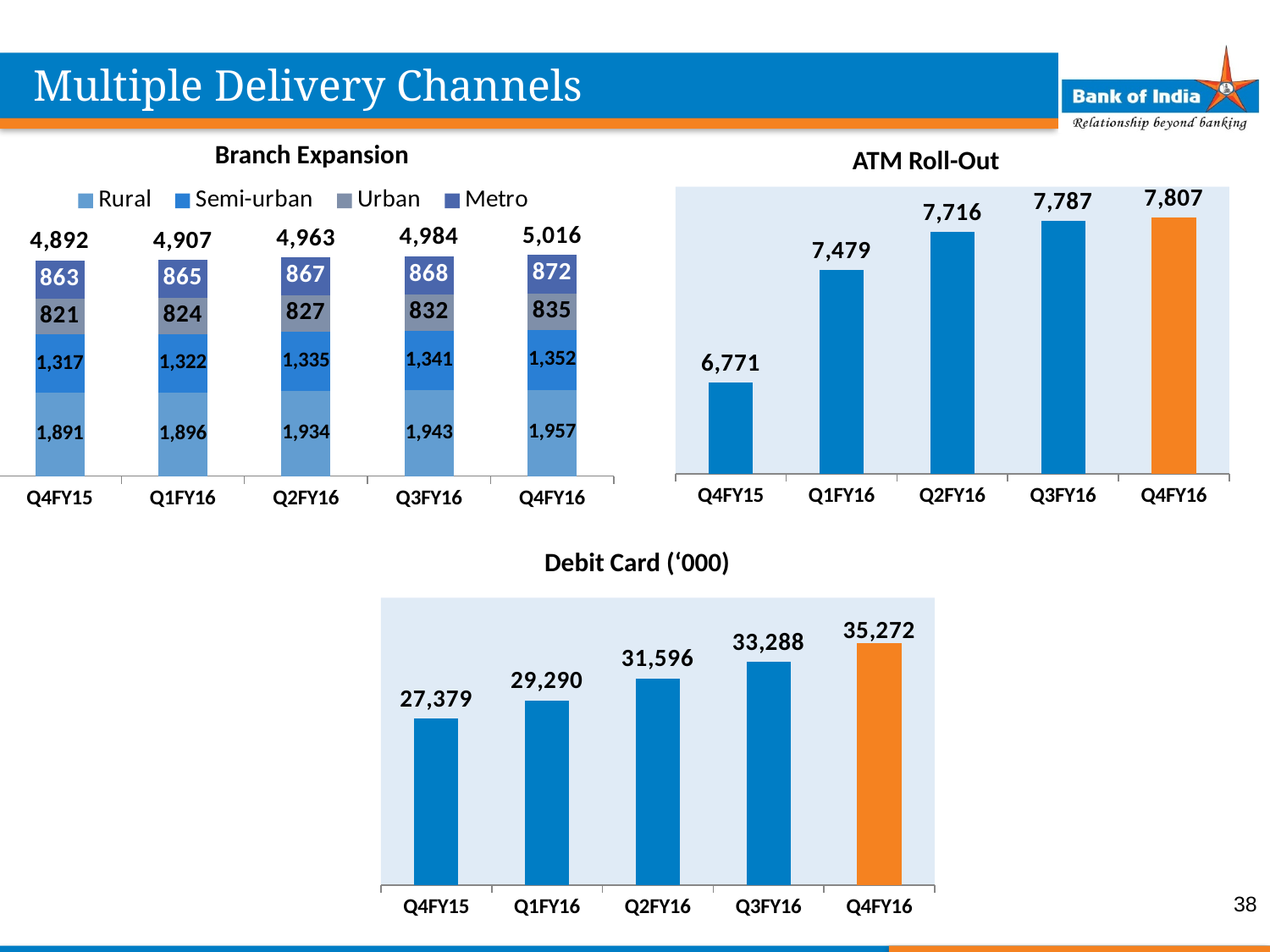
In the ATM Roll-Out chart, which quarter has the lowest value? Q4FY15 In the ATM Roll-Out chart, what is the value for Q1FY16? 7,479 In the ATM Roll-Out chart, what is the difference between Q4FY16 and Q4FY15? 1,036 In the Debit Card ('000) chart, what is the value for Q3FY16? 33,288 In the Debit Card ('000) chart, do the values rise or fall from Q4FY15 to Q4FY16? rise How many quarters are shown on the x axis of the Debit Card ('000) chart? 5 In the Branch Expansion chart, what is the Rural value for Q4FY16? 1,957 How many series does the legend of the Branch Expansion chart list? 4 In the Branch Expansion chart, what is the Metro value for Q1FY16? 865 In the Branch Expansion chart, what is the difference between the Semi-urban values for Q4FY16 and Q4FY15? 35 In the Branch Expansion chart, what is the total of the stacked bar for Q2FY16? 4,963 In the Debit Card ('000) chart, which quarter has the highest value? Q4FY16